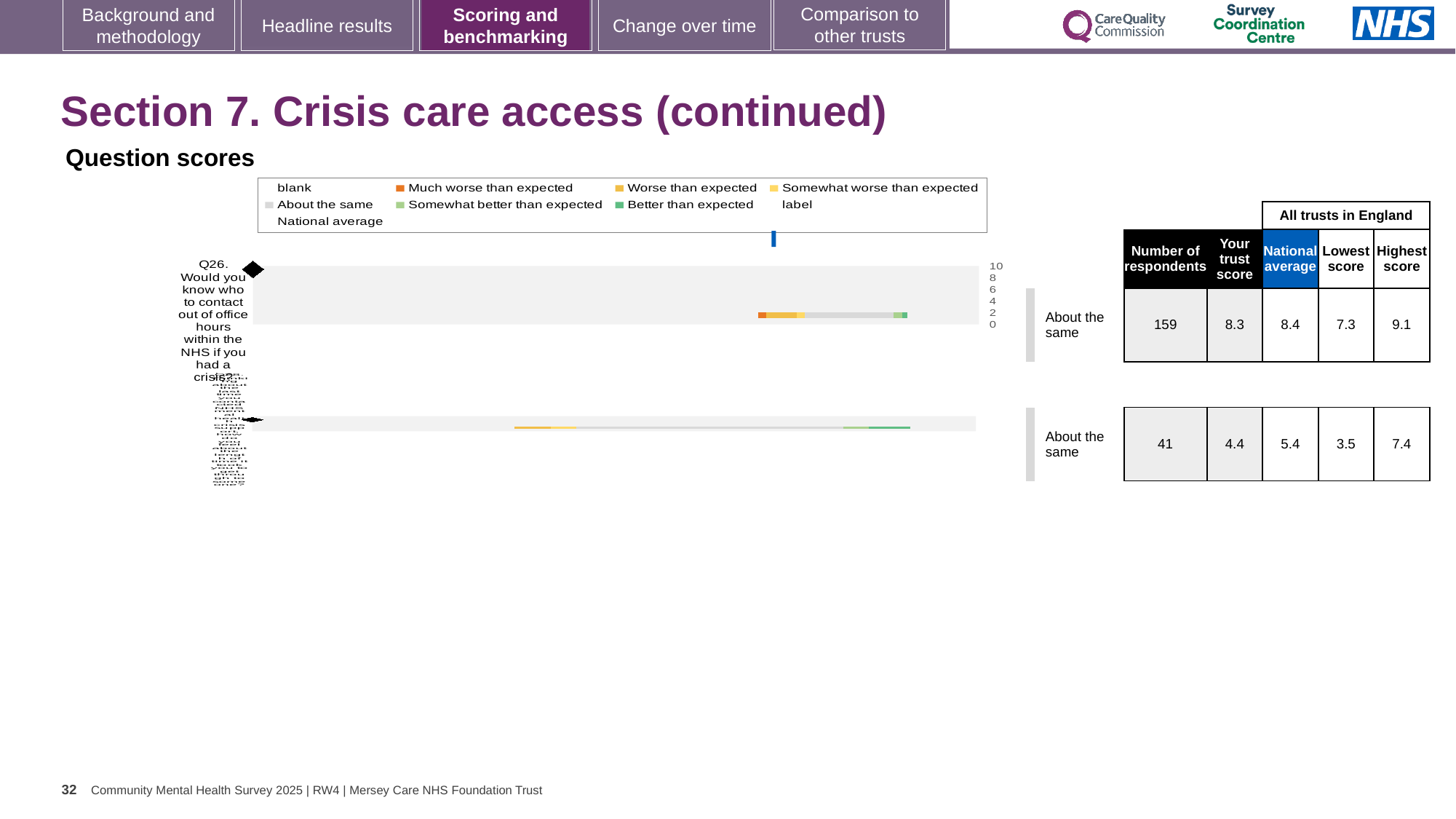
What is the difference between the highest and lowest trust scores in England for Q26? 1.8 What is the lowest score among all trusts in England for Q26? 7.3 What kind of chart is shown under 'Question scores'? bar chart How many respondents answered Q26? 159 What is the trust score for Q26 (Would you know who to contact out of office hours within the NHS if you had a crisis?)? 8.3 How many survey questions are plotted as rows in the chart? 2 What benchmark category is Q26 assigned to? About the same What is the highest value shown on the chart's numeric axis? 10 What is the national average for Q26? 8.4 Which colour in the legend represents 'Much worse than expected'? orange For Q26, which is larger: the trust score or the national average? national average What is the highest score among all trusts in England for Q26? 9.1